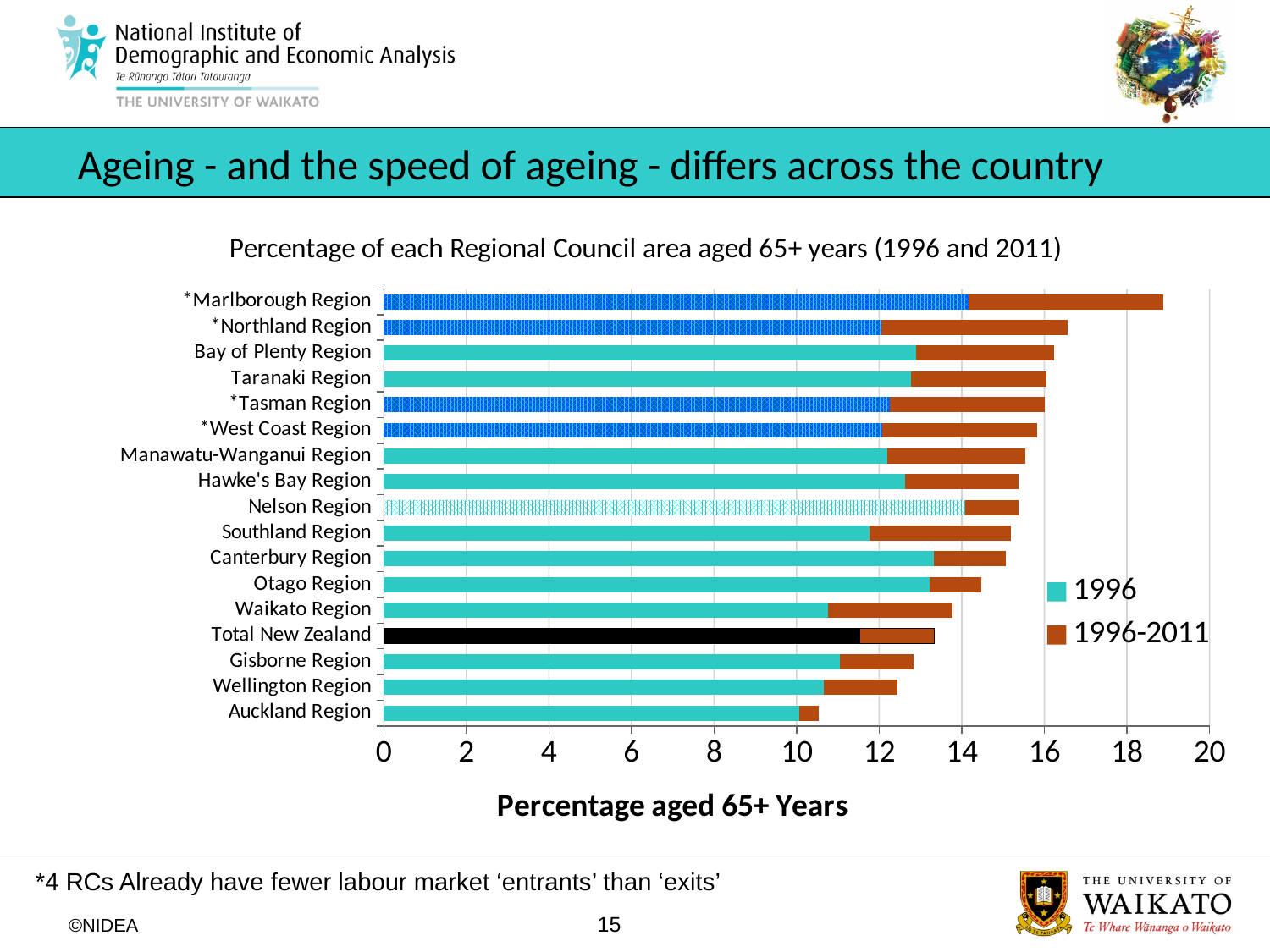
Which region has the highest total percentage aged 65+ years (end of the stacked bar)? *Marlborough Region Is the 1996 value for Canterbury Region greater or less than 12? greater What kind of chart is shown on the slide? bar chart How many series does the chart legend list? 2 Is the total stacked bar for *Marlborough Region greater or less than 18? greater Is the 1996 value for Waikato Region greater or less than 12? less Which is larger, the 1996 value for Canterbury Region or the 1996 value for Waikato Region? Canterbury Region Which region has the lowest total percentage aged 65+ years (end of the stacked bar)? Auckland Region How many regions (categories) are plotted on the chart? 17 What is the title of the x axis? Percentage aged 65+ Years